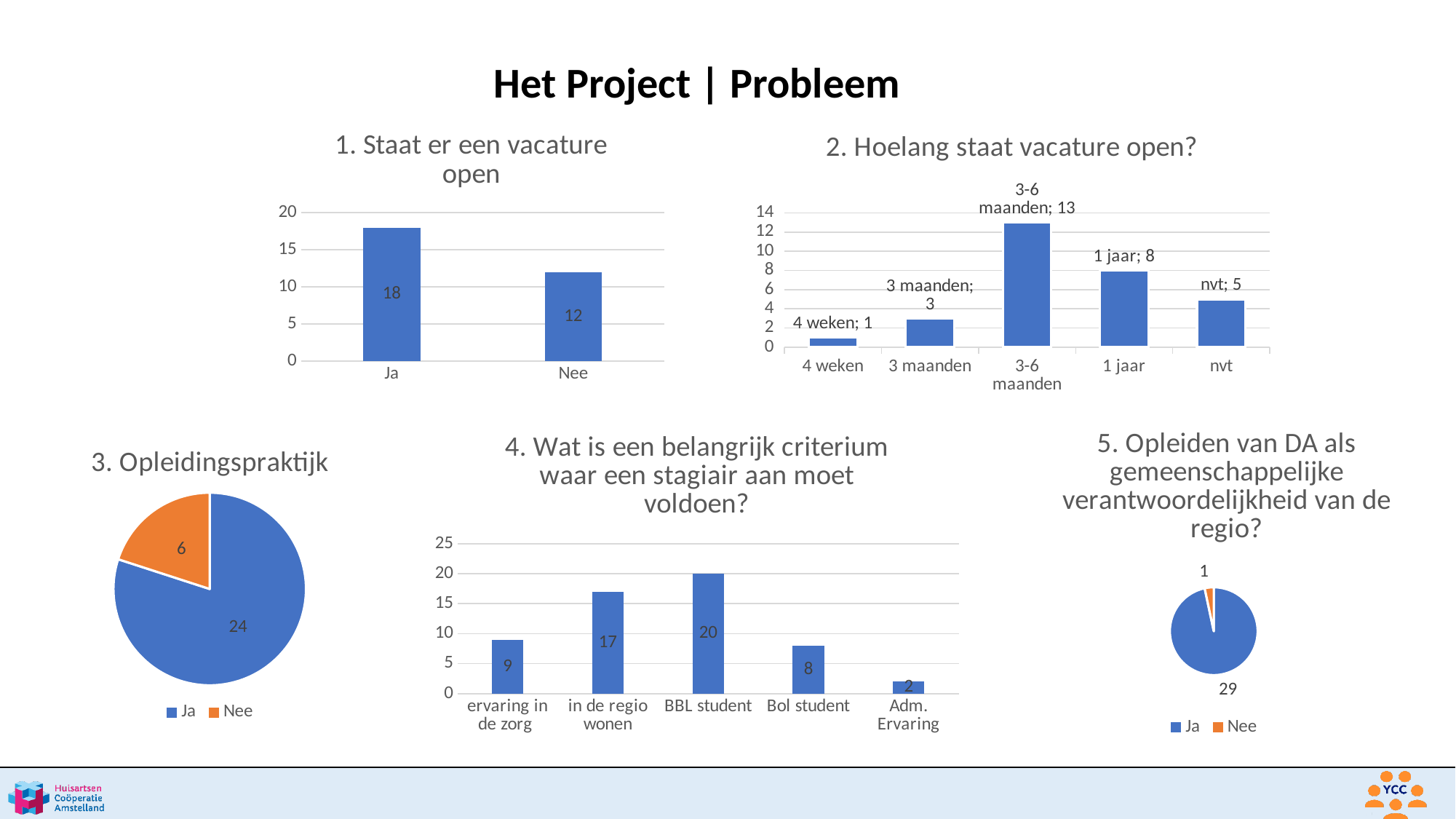
In the chart '2. Hoelang staat vacature open?', which category has the lowest value? 4 weken In the chart '2. Hoelang staat vacature open?', which category has the highest value? 3-6 maanden In the chart '1. Staat er een vacature open', what is the value for Ja? 18 In the chart '4. Wat is een belangrijk criterium waar een stagiair aan moet voldoen?', which is larger: 'ervaring in de zorg' or 'Bol student'? ervaring in de zorg In the chart '2. Hoelang staat vacature open?', how many categories are shown on the x axis? 5 In the chart '1. Staat er een vacature open', what is the difference between Ja and Nee? 6 What kind of chart is '3. Opleidingspraktijk'? pie chart In the chart '3. Opleidingspraktijk', what is the value for Nee? 6 In the chart '3. Opleidingspraktijk', what share of the total does Ja represent? 80% In the chart '4. Wat is een belangrijk criterium waar een stagiair aan moet voldoen?', which category has the highest value? BBL student In the chart '2. Hoelang staat vacature open?', what is the value for 1 jaar? 8 In the chart '5. Opleiden van DA als gemeenschappelijke verantwoordelijkheid van de regio?', what is the value for Ja? 29